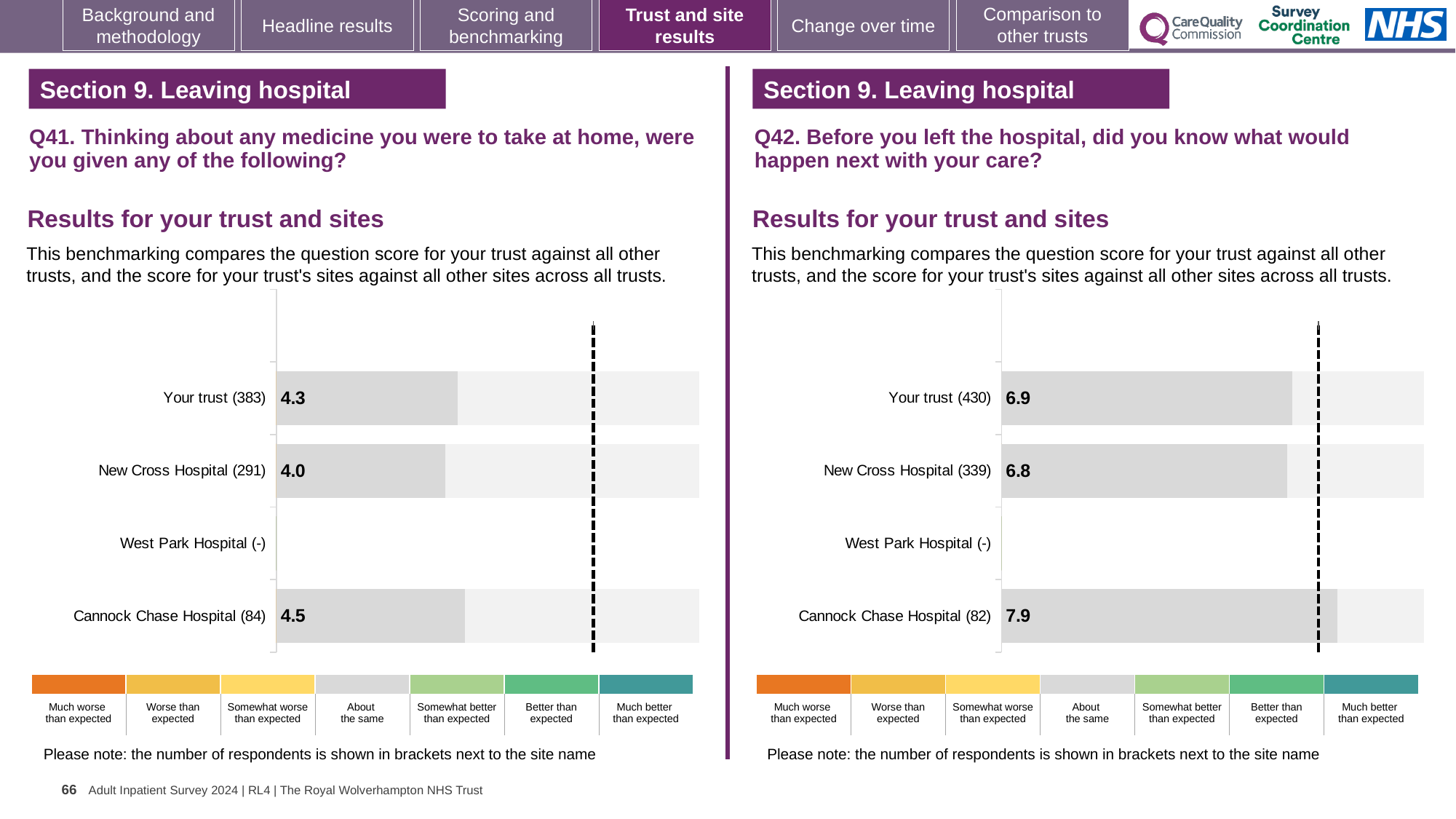
In the Q42 chart on the right, what is the score for Cannock Chase Hospital? 7.9 In the Q41 chart on the left, what is the score for Your trust? 4.3 In the Q42 chart on the right, what is the score for Your trust? 6.9 In the Q42 chart on the right, which site has the lowest score among those with a value shown? New Cross Hospital In the Q42 chart on the right, what is the difference between the scores for Cannock Chase Hospital and Your trust? 1.0 In the Q41 chart on the left, which site has the highest score? Cannock Chase Hospital In the Q41 chart on the left, what is the difference between the scores for Cannock Chase Hospital and New Cross Hospital? 0.5 In the Q42 chart on the right, which has the larger score, Your trust or New Cross Hospital? Your trust In the Q41 chart on the left, what is the score for New Cross Hospital? 4.0 How many categories (rows) are listed in the Q41 chart on the left? 4 In the Q41 chart on the left, what is the score for Cannock Chase Hospital? 4.5 What kind of chart is used in the Q42 chart on the right? Bar chart